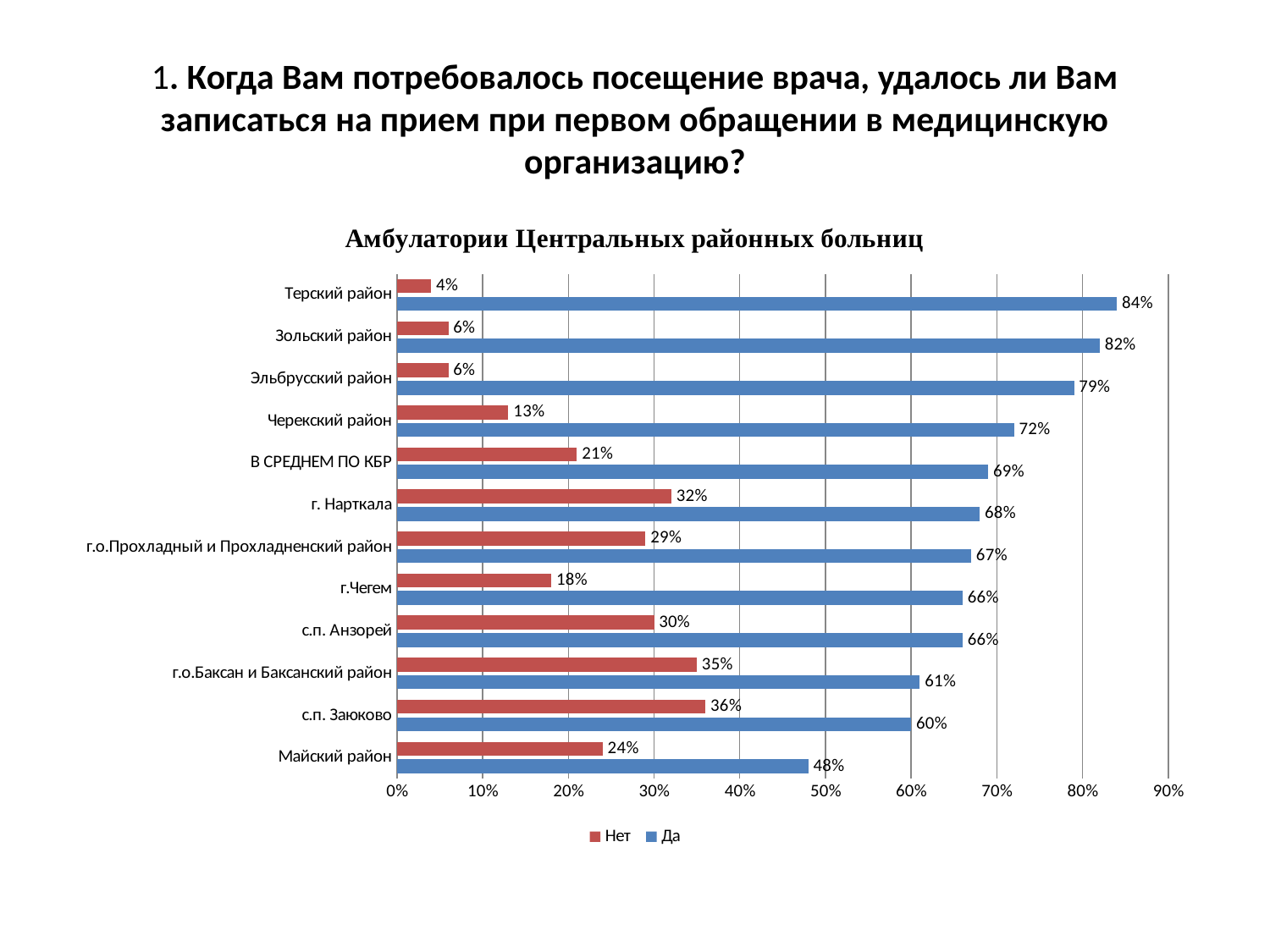
What is the "Да" value for Терский район? 84% What is the "Нет" value for с.п. Заюково? 36% Which is larger: the "Нет" value for г. Нарткала or for г.Чегем? г. Нарткала What kind of chart is shown on the slide? bar chart How many categories are shown on the chart? 12 Which category has the highest "Да" value? Терский район What is the difference between the "Да" values for Терский район and Майский район? 36% Which category has the lowest "Нет" value? Терский район What is the "Да" value for В СРЕДНЕМ ПО КБР? 69% How many series does the legend list? 2 What is the title of the chart? Амбулатории Центральных районных больниц Which category has the lowest "Да" value? Майский район